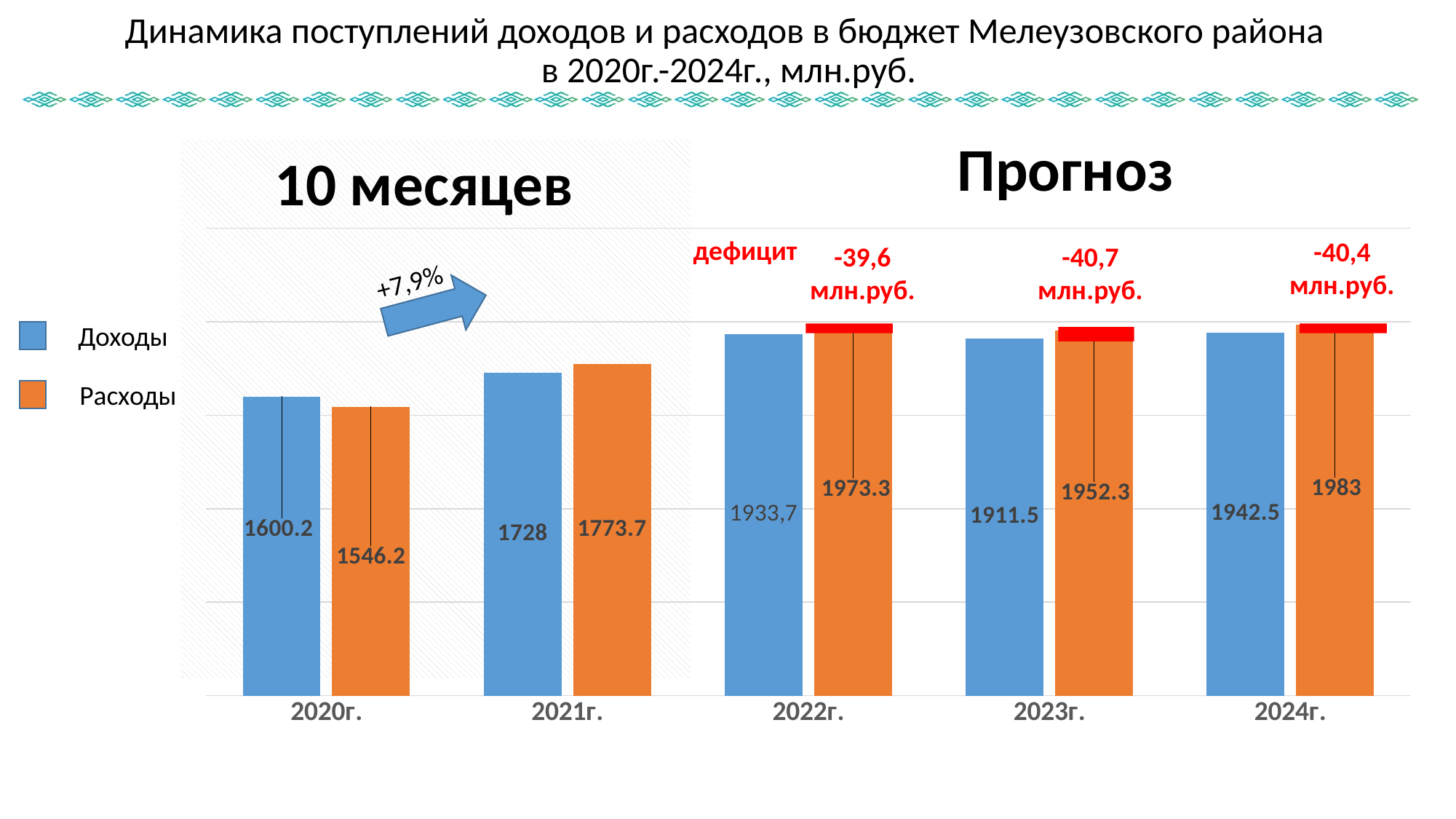
What is the value of Доходы for 2023г.? 1911.5 What is the difference between Расходы and Доходы in 2021г.? 45.7 What kind of chart is shown on the slide? bar chart How many series does the legend list? 2 In which year is Доходы the lowest? 2020г. Which is larger in 2020г., Доходы or Расходы? Доходы What is the value of Расходы for 2021г.? 1773.7 What percentage growth is shown by the arrow between 2020г. and 2021г.? +7,9% What is the value of Доходы for 2020г.? 1600.2 What is the value of Расходы for 2024г.? 1983 In which year is Расходы the highest? 2024г. How many years are shown on the x axis? 5